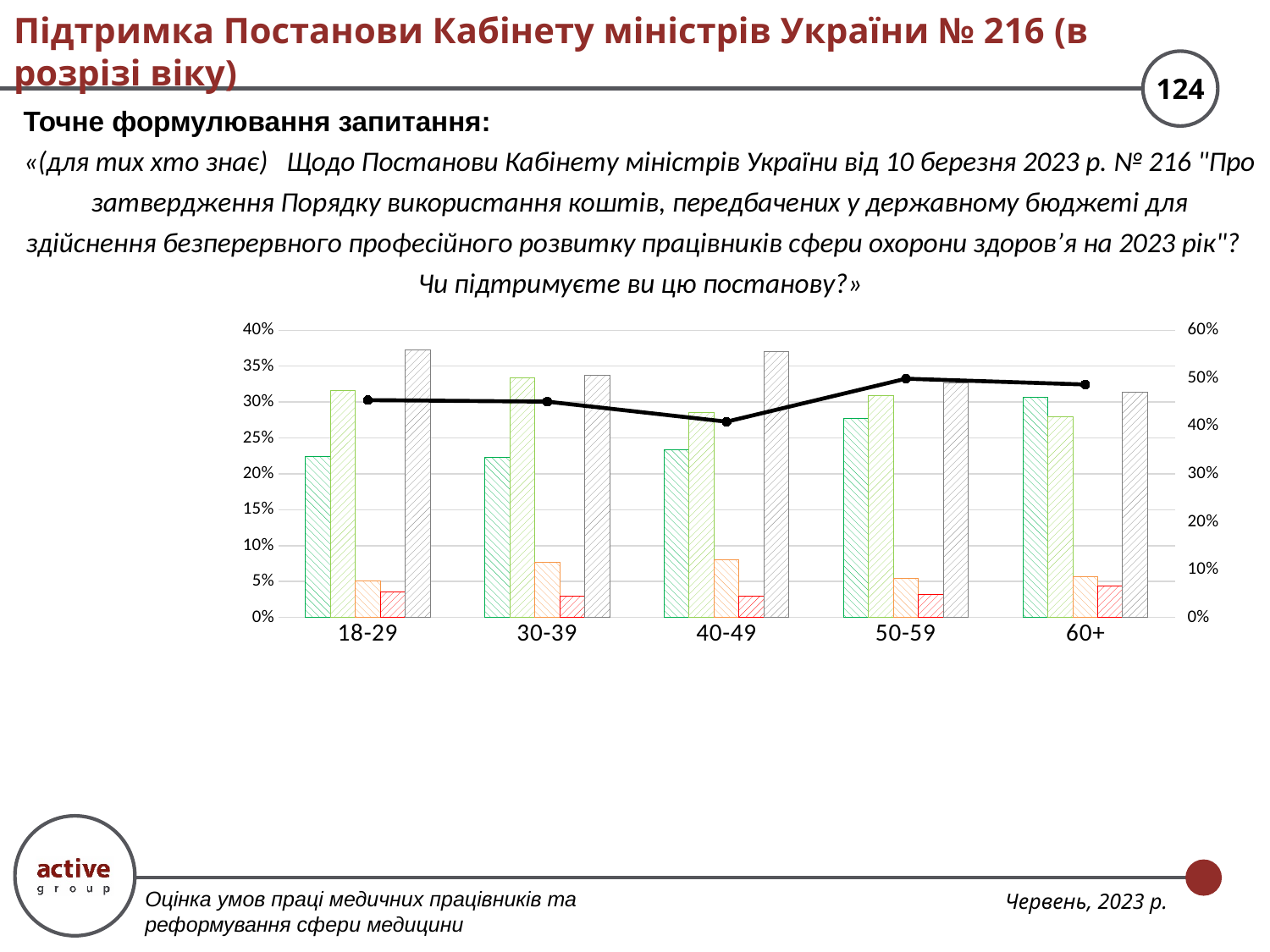
Is the value of the black line for the 18-29 age group greater or less than 40% on the right axis? greater Does the black line rise or fall between the 40-49 and 50-59 age groups? rises How many bars are plotted for each age group in the chart? 5 What is the highest value shown on the left vertical axis of the chart? 40% What kind of chart is shown on the slide? bar chart with a line Does the black line rise or fall between the 30-39 and 40-49 age groups? falls Which age group is the first category on the x axis of the chart? 18-29 How many age groups are shown on the x axis of the chart? 5 Is the value of the black line for the 50-59 age group greater or less than 40% on the right axis? greater